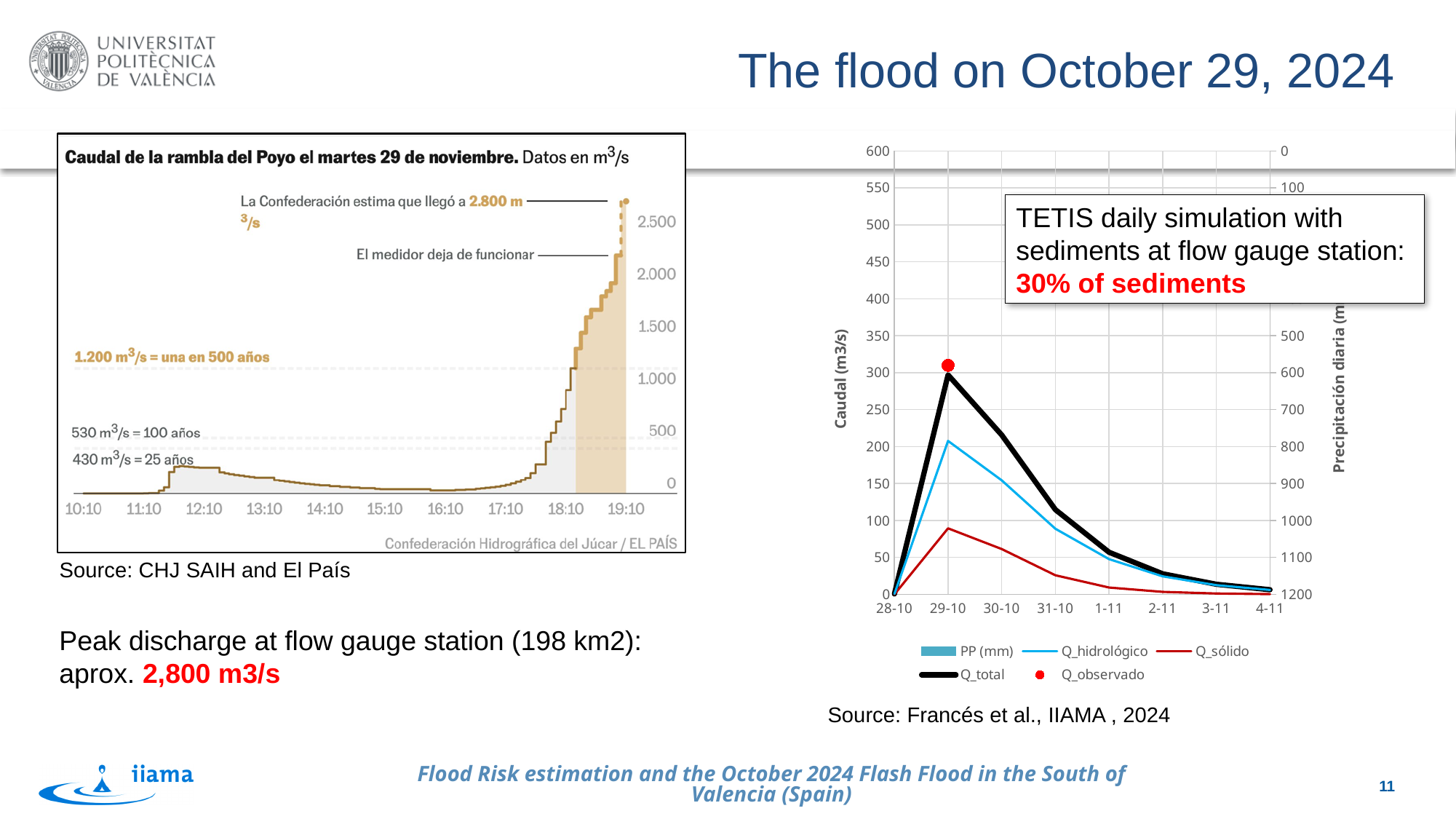
In the right-hand chart, on which date does Q_total reach its highest value? 29-10 In the right-hand chart, does Q_total rise or fall from 29-10 to 4-11? Fall In the right-hand chart, is the Q_hidrológico value on 29-10 greater or less than 150? greater In the right-hand chart, what colour is the Q_total line? Black What kind of chart is the chart on the right of the slide (TETIS simulation)? Line chart In the left-hand chart (Caudal de la rambla del Poyo), what peak discharge does the Confederación estimate was reached? 2.800 m³/s How many series does the legend of the right-hand chart list? 5 In the right-hand chart, is the Q_sólido value on 29-10 greater or less than 100? less In the right-hand chart, is the Q_total value on 29-10 greater or less than 250? greater In the right-hand chart, which is larger on 29-10: Q_hidrológico or Q_sólido? Q_hidrológico How many dates are shown on the x axis of the right-hand chart? 8 In the left-hand chart, what discharge is labelled as a once-in-500-years event? 1.200 m³/s